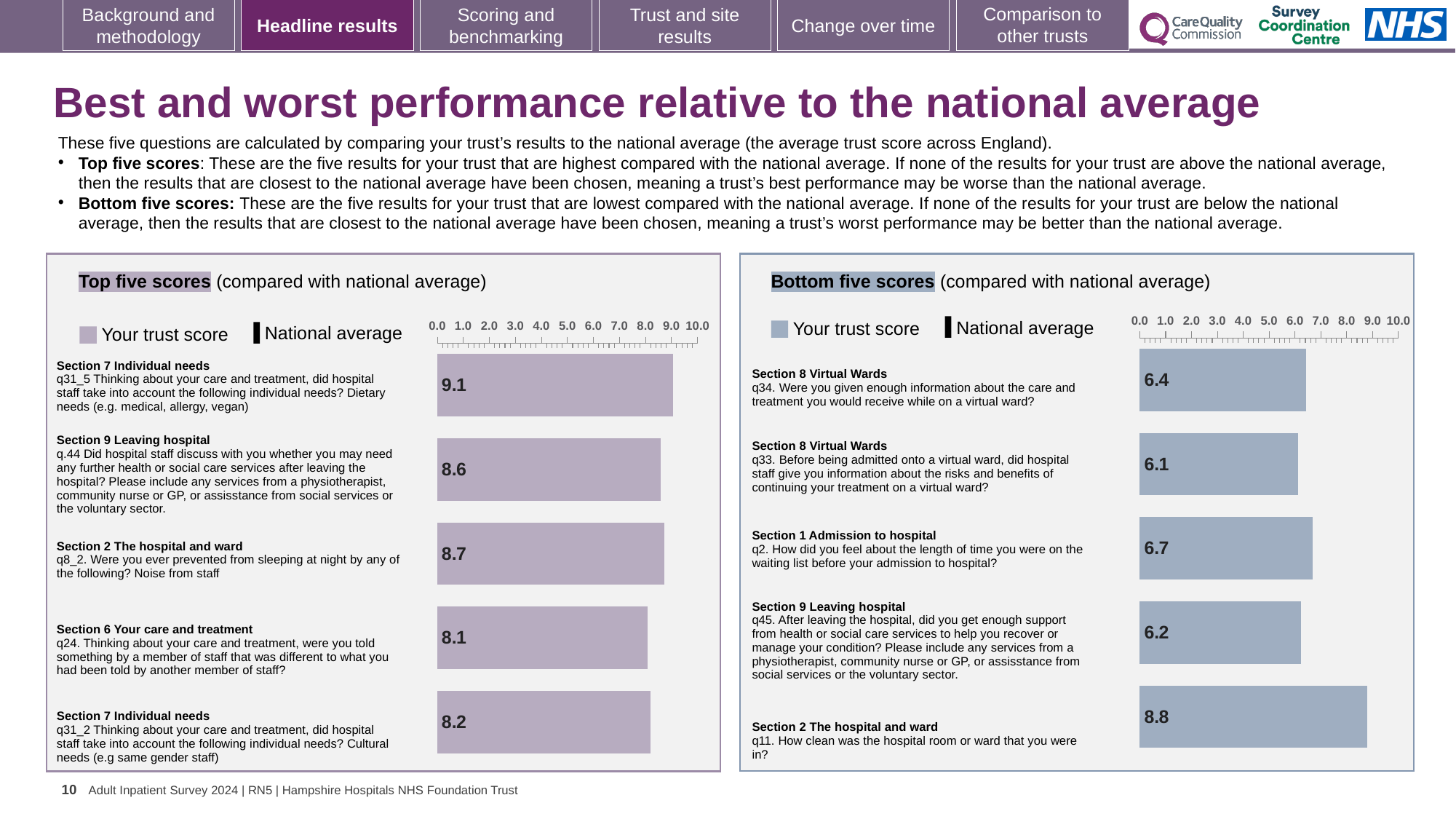
In the Top five scores chart, which question has the highest trust score? q31_5 (dietary needs) How many bars are shown in the Top five scores chart? 5 In the Bottom five scores chart, what is the trust score for q11 (how clean was the hospital room or ward)? 8.8 In the Bottom five scores chart, is the score for q34 larger or smaller than the score for q2? smaller In the Bottom five scores chart, which question has the highest trust score? q11 In the Top five scores chart, which question has the lowest trust score? q24 In the Bottom five scores chart, what is the difference between the scores for q2 and q45? 0.5 In the Bottom five scores chart, what is the trust score for q33 (information about risks and benefits of a virtual ward)? 6.1 In the Top five scores chart, what is the difference between the scores for q31_5 and q31_2? 0.9 In the Top five scores chart, what is the trust score for q31_5 (dietary needs)? 9.1 In the Top five scores chart, what is the trust score for q24 (told something different by another member of staff)? 8.1 In the Bottom five scores chart, which question has the lowest trust score? q33